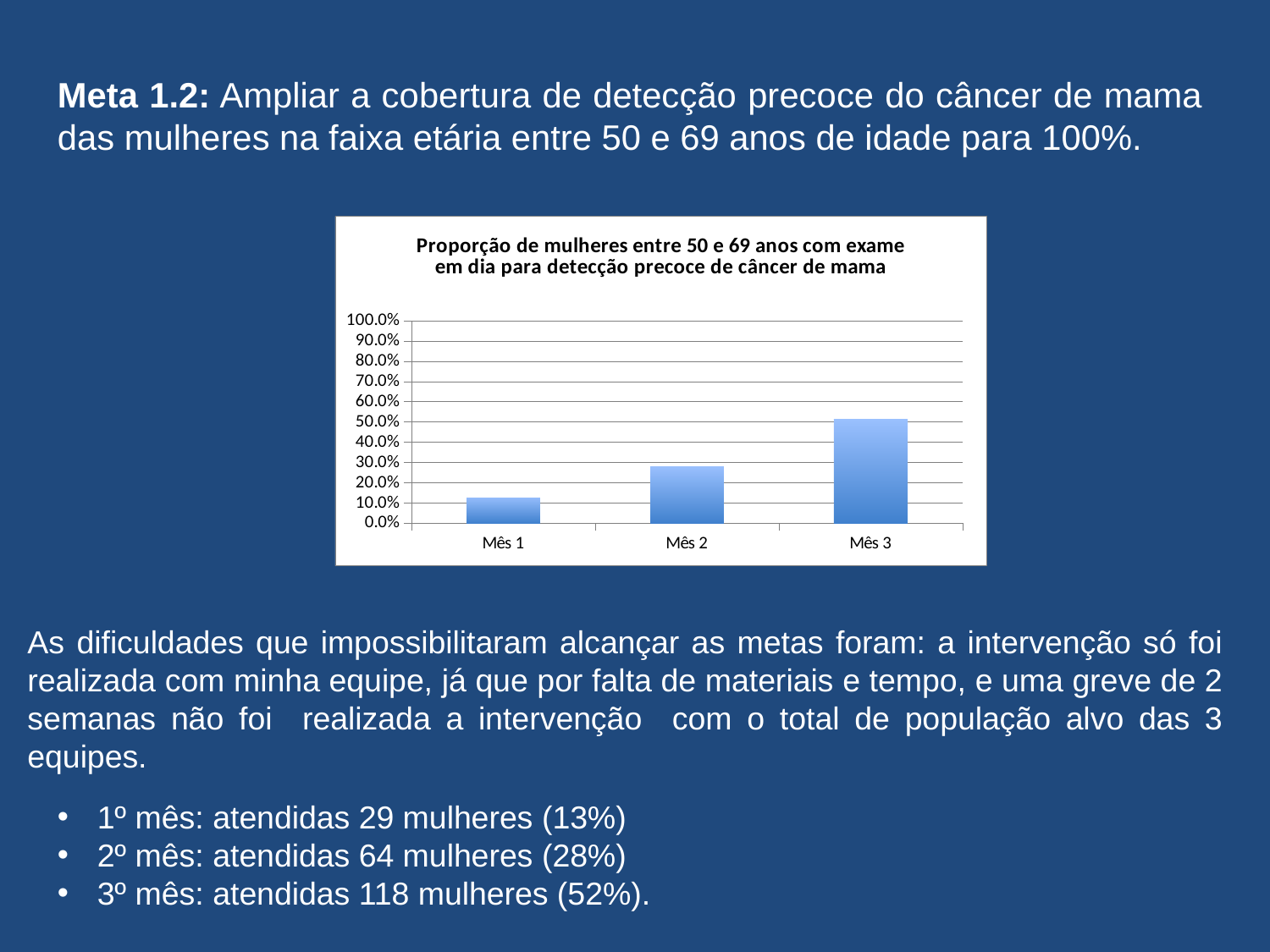
Is the value for Mês 2 greater or less than 30.0%? less Is the value for Mês 2 greater or less than 20.0%? greater Which month has the lowest bar in the chart? Mês 1 Which month has the highest bar in the chart? Mês 3 Which is larger, the value for Mês 2 or the value for Mês 3? Mês 3 Do the values rise or fall from Mês 1 to Mês 3? rise Is the value for Mês 1 greater or less than 10.0%? greater What is the highest tick value shown on the y axis of the chart? 100.0% What kind of chart is shown on the slide? bar chart How many categories are shown on the x axis of the chart? 3